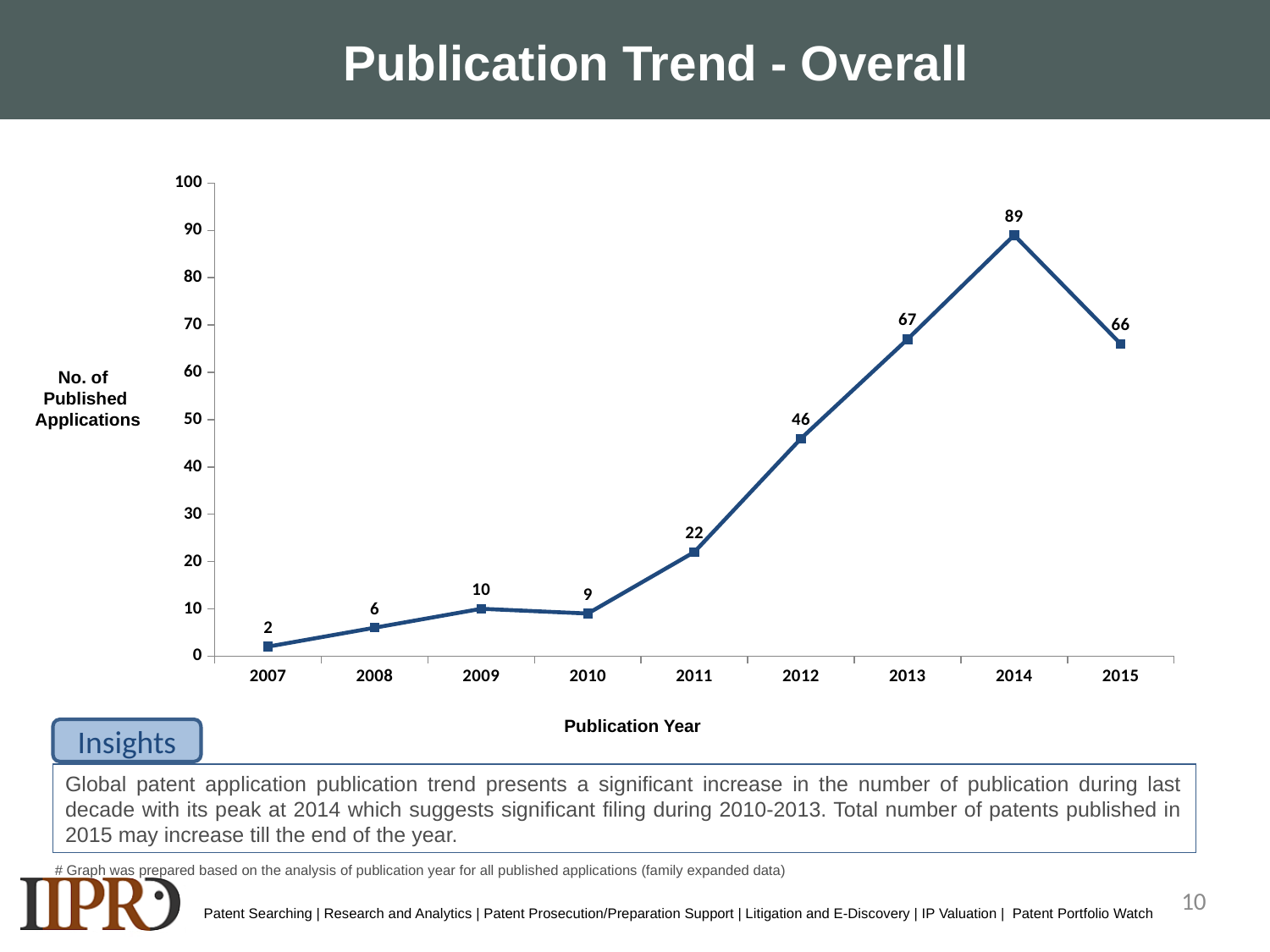
What is the difference between the number of published applications in 2013 and 2012? 21 What is the label of the x axis? Publication Year What is the number of published applications in 2007? 2 What is the number of published applications in 2010? 9 What is the number of published applications in 2014? 89 How many publication years are plotted on the chart? 9 Is the value for 2012 greater or less than 40? greater Which year has more published applications, 2009 or 2010? 2009 What kind of chart is shown on the slide? line chart What is the difference between the number of published applications in 2014 and 2015? 23 Which publication year has the highest number of published applications? 2014 Which publication year has the lowest number of published applications? 2007